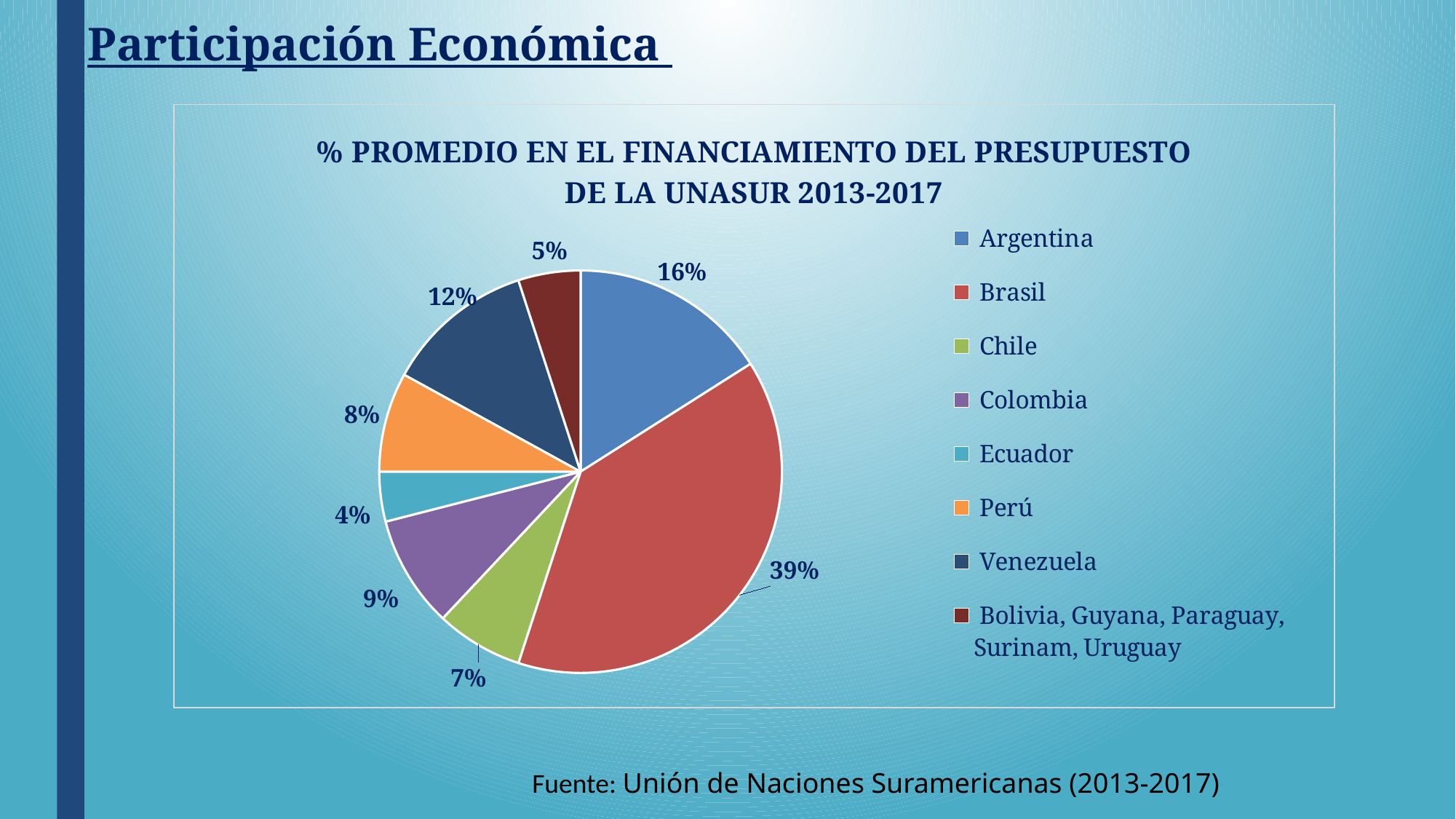
Which has a larger share, Colombia or Perú? Colombia What share of the UNASUR budget financing does Brasil account for? 39% Which legend entry groups Bolivia, Guyana, Paraguay, Surinam and Uruguay together, and what is its share? Bolivia, Guyana, Paraguay, Surinam, Uruguay; 5% What share of the UNASUR budget financing does Argentina account for? 16% What share of the UNASUR budget financing does Ecuador account for? 4% What share of the UNASUR budget financing does Venezuela account for? 12% How many slices does the pie chart have? 8 What is the title of the chart? % PROMEDIO EN EL FINANCIAMIENTO DEL PRESUPUESTO DE LA UNASUR 2013-2017 What kind of chart is shown on the slide? pie chart What is the difference between Brasil's share and Argentina's share? 23% Which country has the largest share of the UNASUR budget financing? Brasil Which legend entry has the smallest share of the UNASUR budget financing? Ecuador